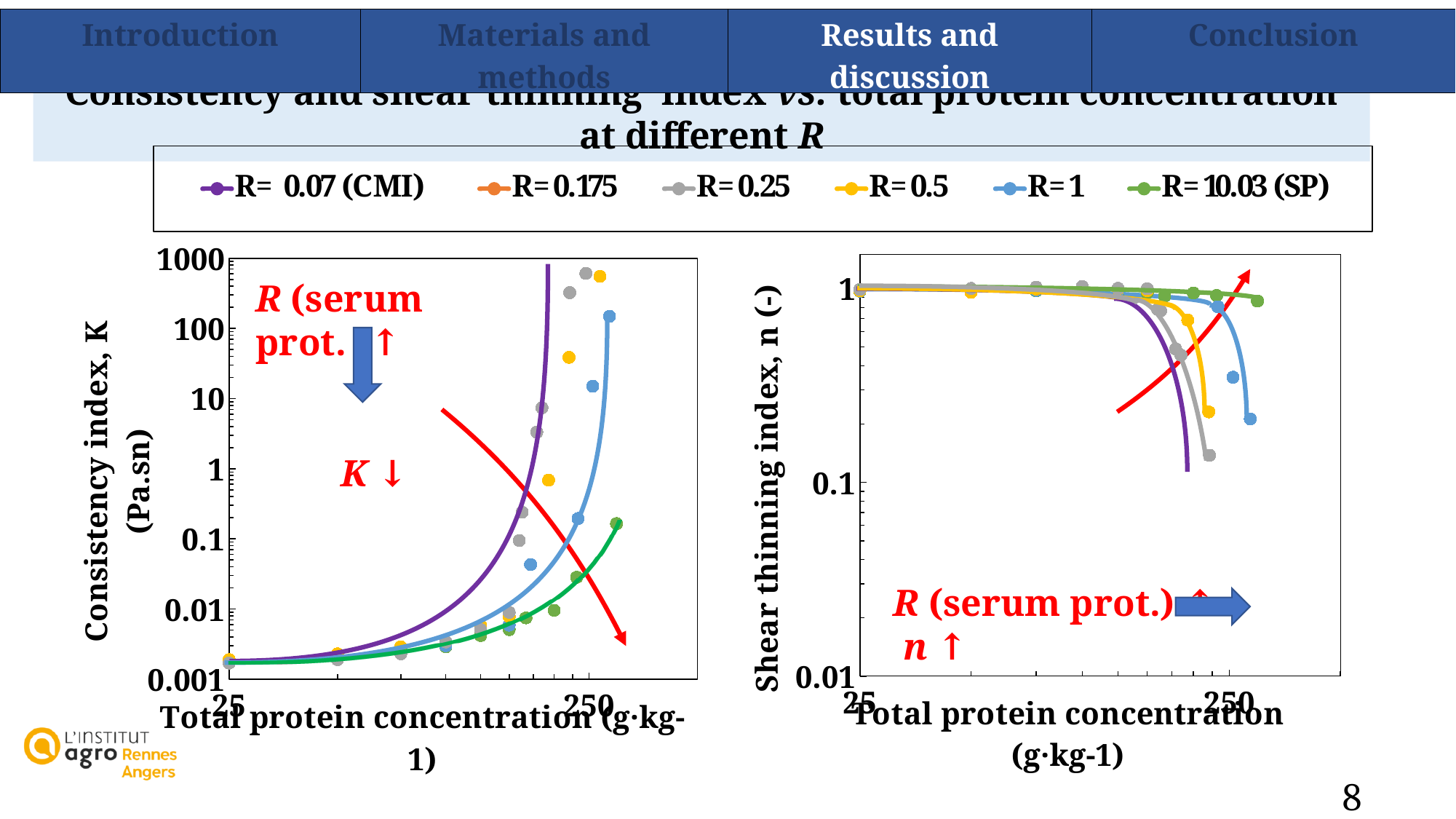
In the left chart, does the consistency index K rise or fall as total protein concentration increases? rise How many series does the legend list? 6 In the right chart, is the shear thinning index for R= 10.03 (SP) at its highest concentration greater or less than 0.1? greater In the right chart, is the lowest shear thinning index value for R= 0.07 (CMI) greater or less than 1? less Which series in the legend is labelled with (SP)? R= 10.03 (SP) Which series in the legend is labelled with (CMI)? R= 0.07 (CMI) In the left chart, is the consistency index for R= 10.03 (SP) at 25 g·kg-1 greater or less than 0.01? less What kind of chart is the left chart (Consistency index, K vs. total protein concentration)? scatter chart How many charts are shown on the slide? 2 What is the y-axis label of the right chart? Shear thinning index, n (-) In the right chart, does the shear thinning index n rise or fall as total protein concentration increases? fall